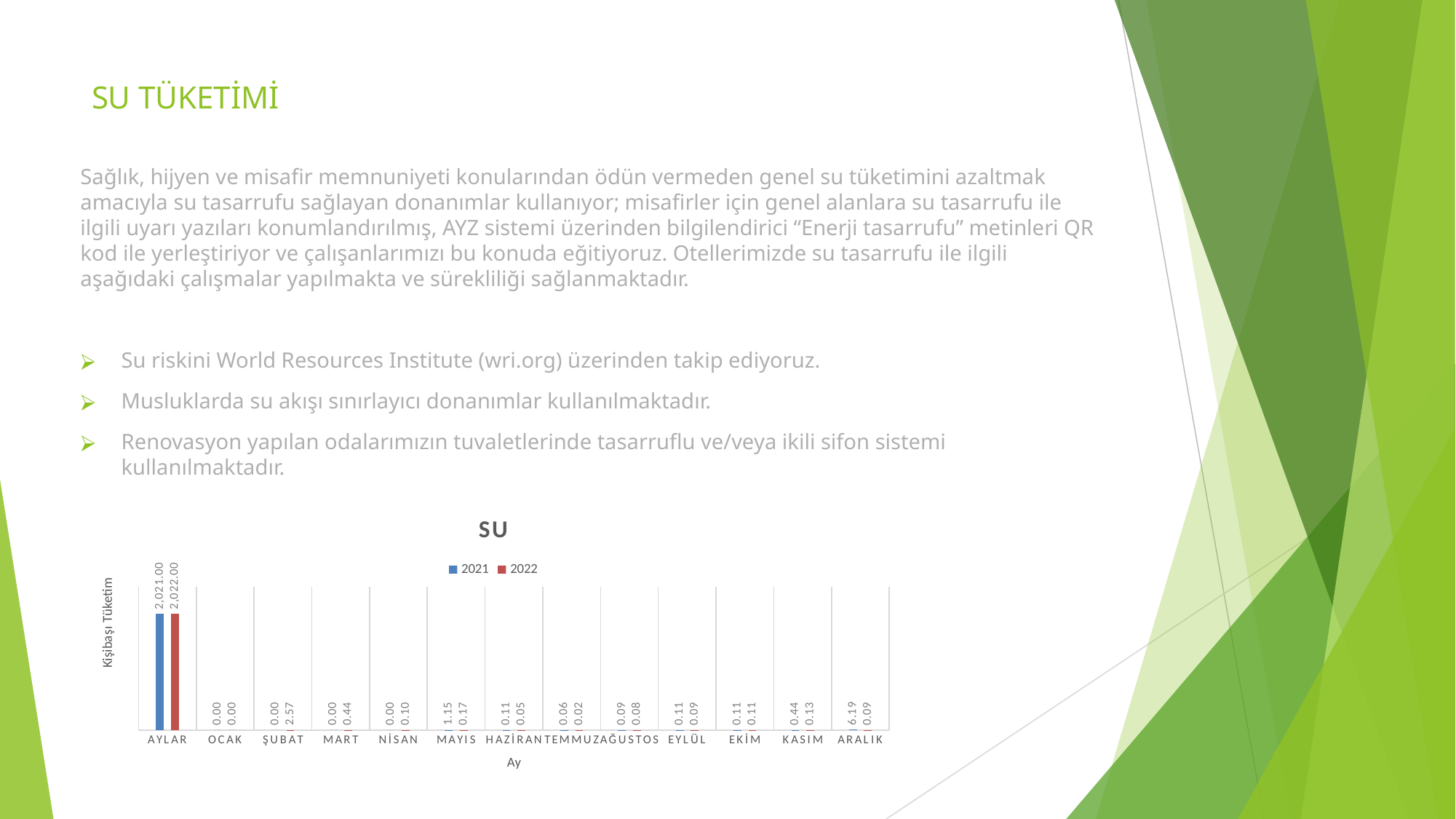
What is the difference between the 2021 and 2022 values for ARALIK? 6.10 Which month has the highest 2022 value (excluding the AYLAR column)? ŞUBAT What is the 2022 value for ŞUBAT? 2.57 What is the 2021 value for MAYIS? 1.15 What is the title of the chart on the slide? SU How many series does the chart legend list? 2 What kind of chart is shown on the slide? bar chart What is the label of the vertical axis? Kişibaşı Tüketim Which month has the highest 2021 value (excluding the AYLAR column)? ARALIK Which is larger for KASIM, the 2021 value or the 2022 value? 2021 What is the 2021 value for ARALIK? 6.19 What is the 2022 value for KASIM? 0.13